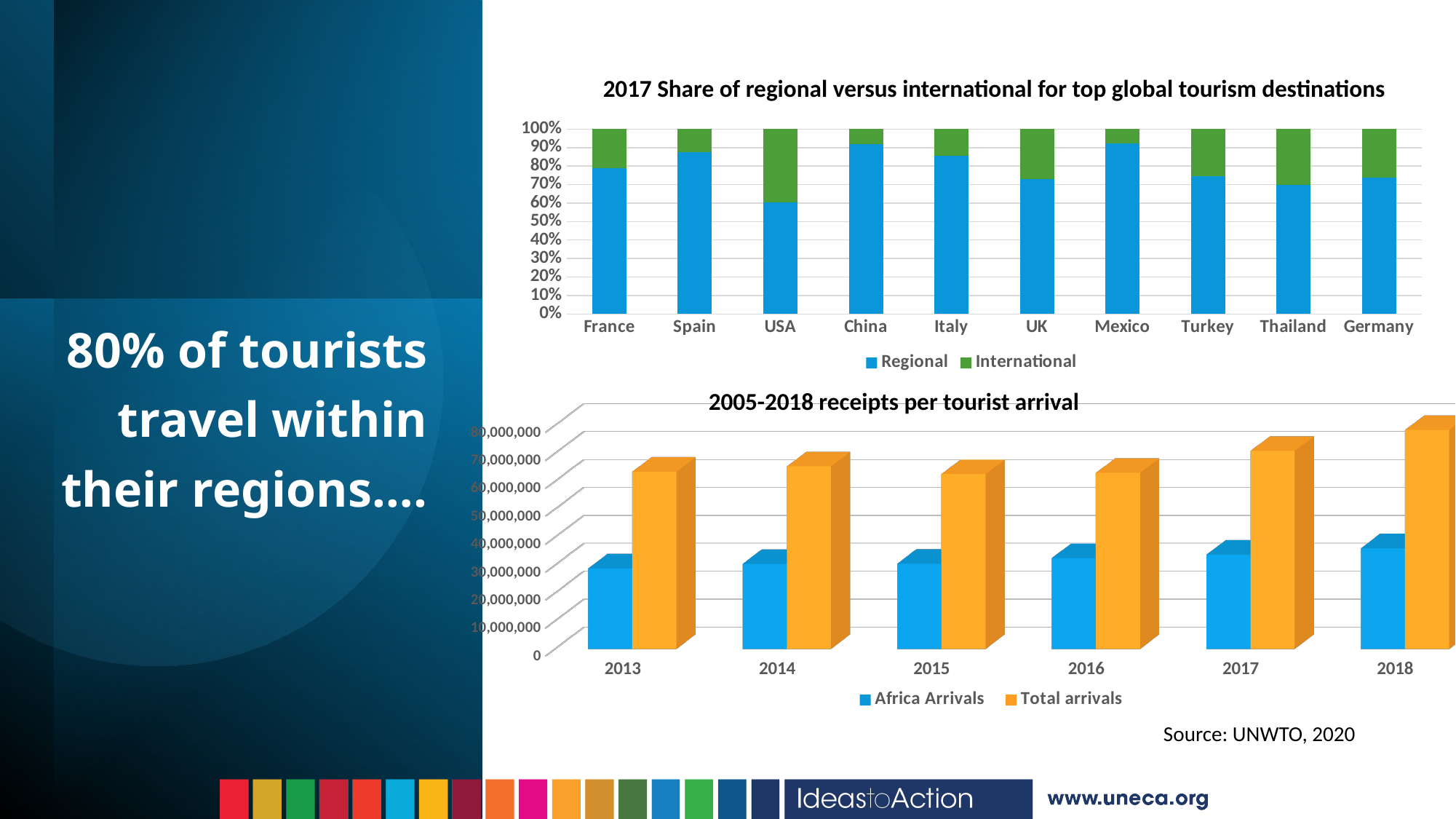
In the bottom chart (2005-2018 receipts per tourist arrival), how many years are shown on the x axis? 6 In the bottom chart (2005-2018 receipts per tourist arrival), which year has the highest Total arrivals? 2018 In the top chart (2017 Share of regional versus international), which is larger: the Regional share for Spain or the Regional share for USA? Spain In the bottom chart (2005-2018 receipts per tourist arrival), which is larger in 2017: Africa Arrivals or Total arrivals? Total arrivals In the top chart (2017 Share of regional versus international), which destination has the highest International share? USA In the top chart (2017 Share of regional versus international), how many destinations are shown on the x axis? 10 In the top chart (2017 Share of regional versus international), which destination has the lowest Regional share? USA In the top chart (2017 Share of regional versus international), how many series does the legend list? 2 In the bottom chart (2005-2018 receipts per tourist arrival), is the value for Total arrivals in 2018 greater or less than 70,000,000? greater In the top chart (2017 Share of regional versus international), what colour represents the International series? green In the top chart (2017 Share of regional versus international), is the Regional share for France greater or less than 70%? greater What kind of chart is the top chart titled '2017 Share of regional versus international for top global tourism destinations'? stacked bar chart